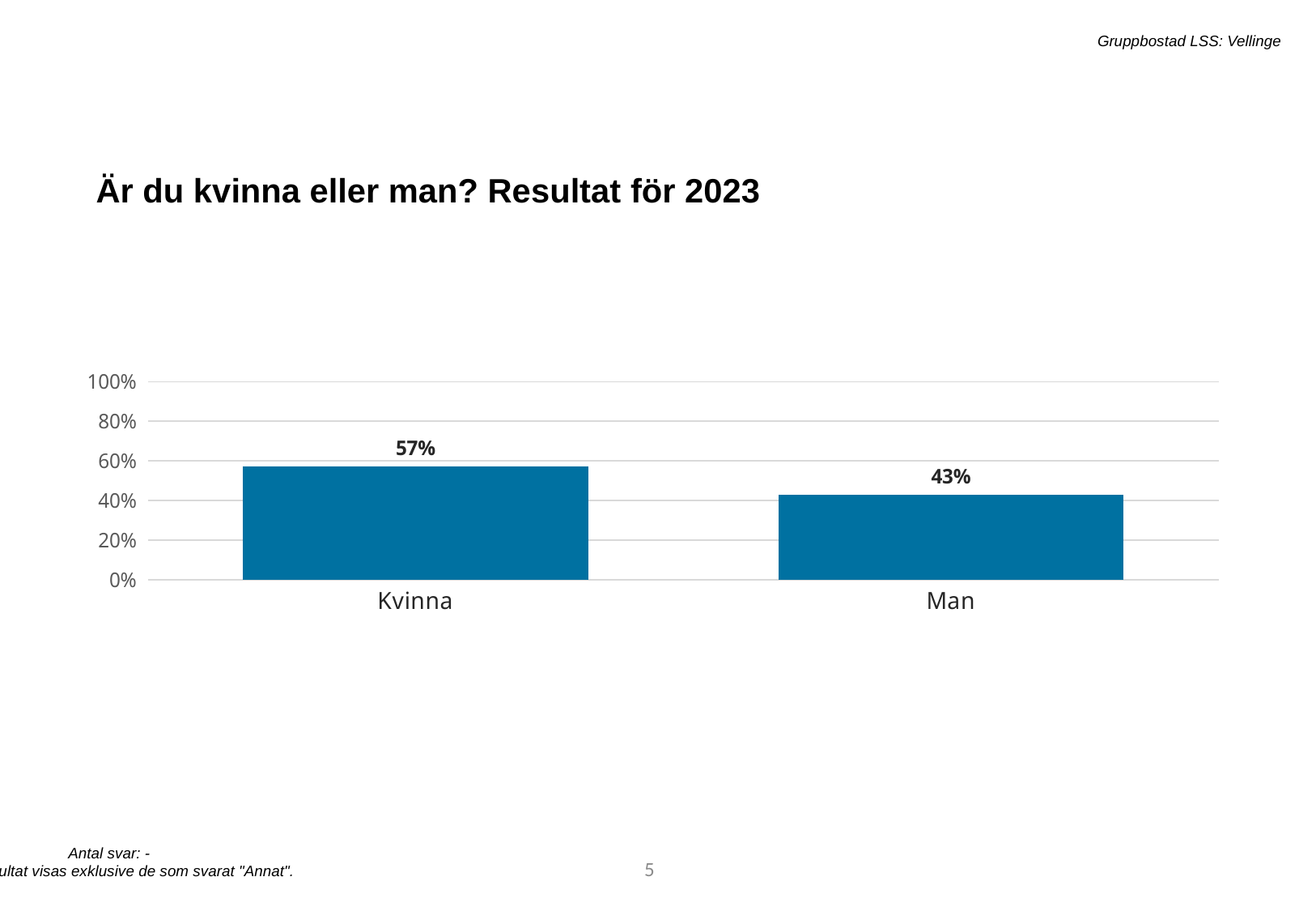
Which is larger, the value for Kvinna or the value for Man? Kvinna What is the value for Kvinna? 57% Is the value for Man greater or less than 60%? less Is the value for Kvinna greater or less than 40%? greater What is the difference between the values for Kvinna and Man? 14% Which category has the lowest value? Man Which category has the highest value? Kvinna What kind of chart is shown on the slide? bar chart What is the title of the slide? Är du kvinna eller man? Resultat för 2023 What is the value for Man? 43% How many categories are shown on the x axis? 2 What is the highest value shown on the y axis? 100%